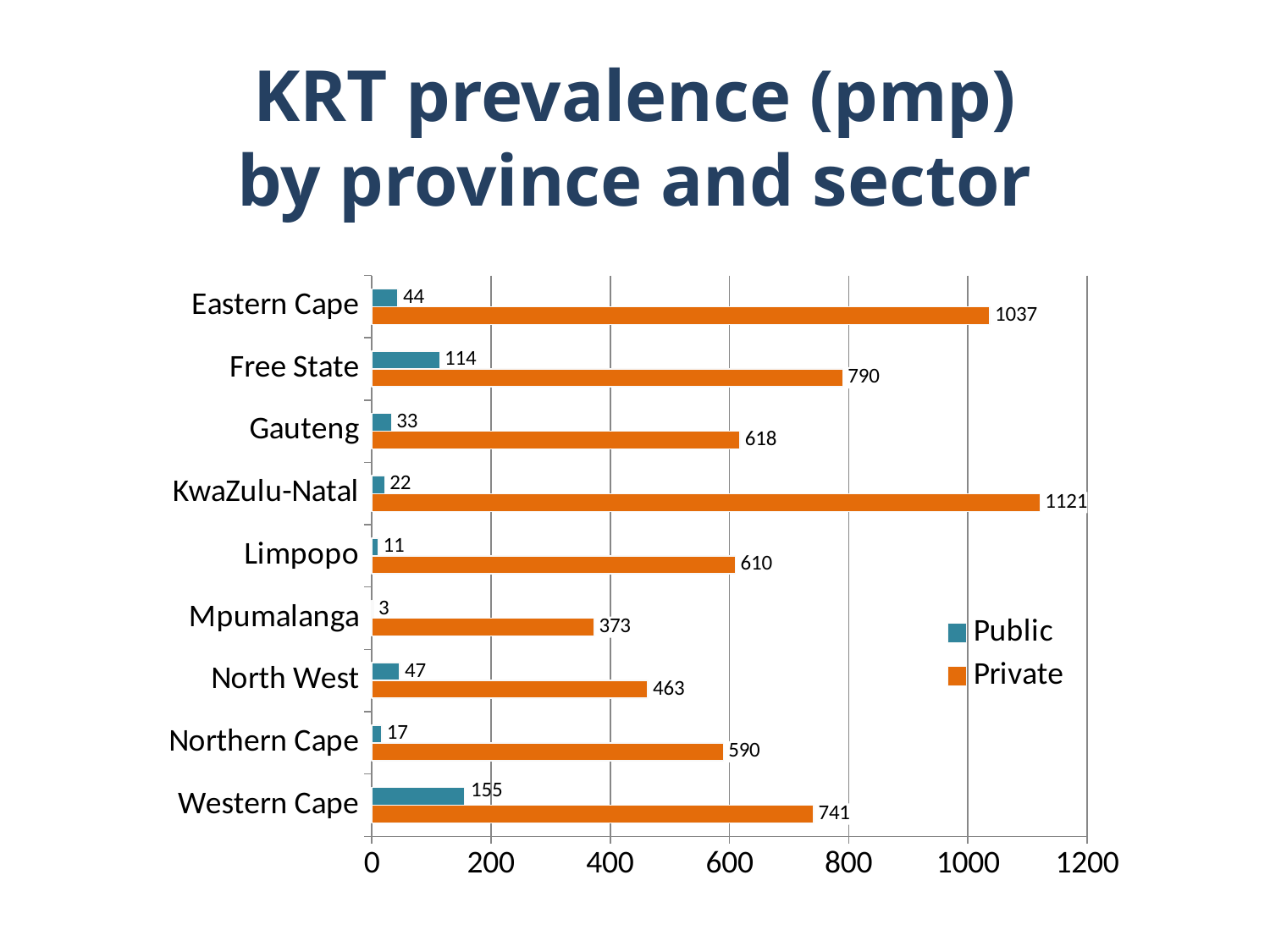
Is the Private value for Eastern Cape greater or less than 1000? greater Which province has the lowest Private KRT prevalence? Mpumalanga What kind of chart is shown on the slide? Bar chart Which is larger, the Private value for Gauteng or the Private value for Limpopo? Gauteng What is the Public value for Mpumalanga? 3 Which province has the lowest Public KRT prevalence? Mpumalanga How many provinces are shown on the chart? 9 What is the Public KRT prevalence for Western Cape? 155 Which province has the highest Private KRT prevalence? KwaZulu-Natal What is the difference between the Private and Public values for Free State? 676 How many series does the legend list? 2 What is the Private KRT prevalence for KwaZulu-Natal? 1121